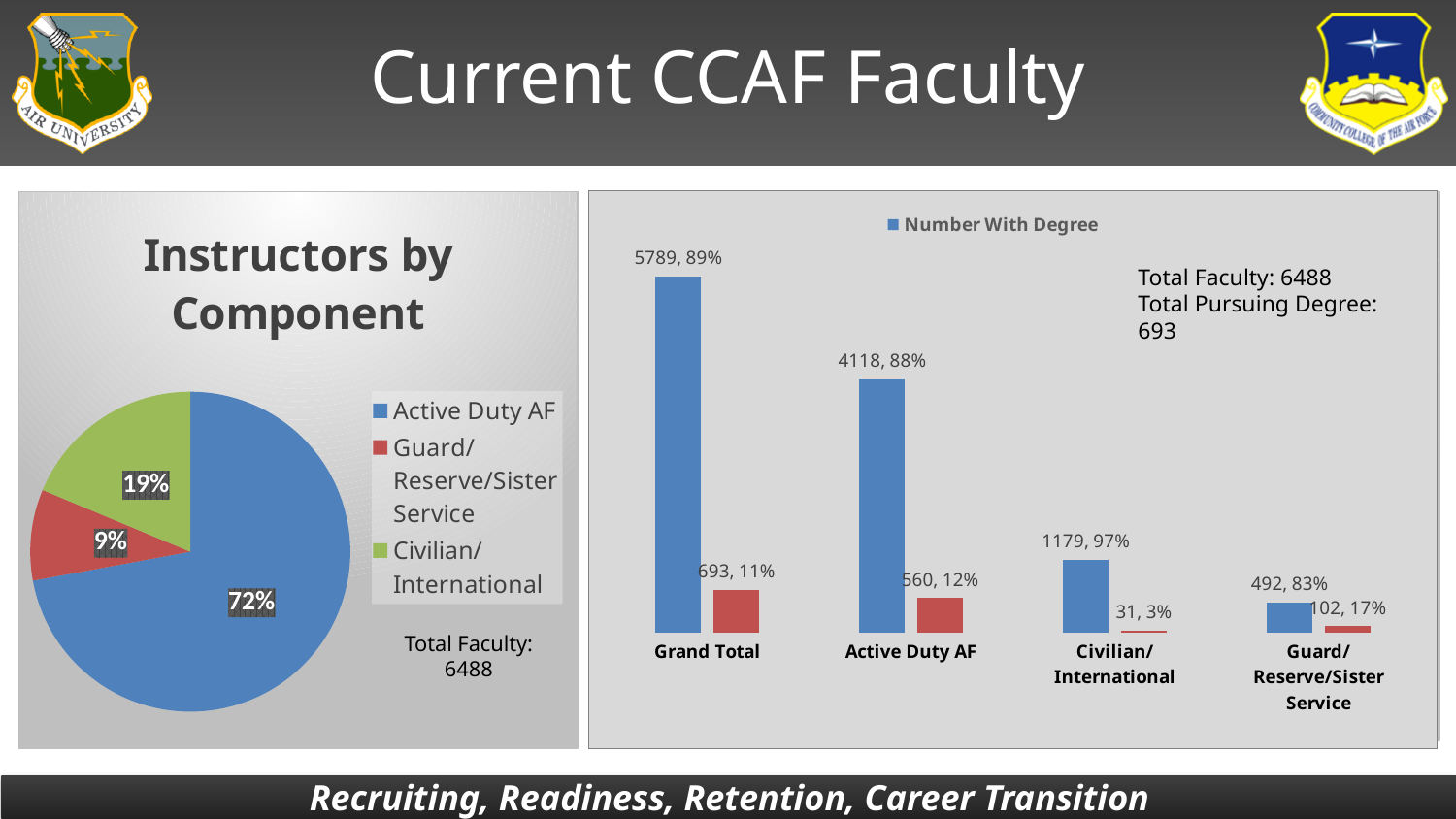
What type of chart is the chart on the right of the slide? Bar chart In the bar chart on the right, what is the Number With Degree value for Civilian/International? 1179, 97% In the bar chart on the right, what is the difference between the Number With Degree for Active Duty AF and for Civilian/International? 2939 In the 'Instructors by Component' pie chart, which component has the smallest slice? Guard/Reserve/Sister Service In the bar chart on the right, what is the Number With Degree value for Guard/Reserve/Sister Service? 492, 83% In the bar chart on the right, what is the Number With Degree value for Grand Total? 5789, 89% In the 'Instructors by Component' pie chart, what share of instructors is Active Duty AF? 72% In the bar chart on the right, how many categories are shown on the x axis? 4 In the 'Instructors by Component' pie chart, what share of instructors is Civilian/International? 19% In the bar chart on the right, which category has the lowest Number With Degree? Guard/Reserve/Sister Service What type of chart is the 'Instructors by Component' chart on the left? Pie chart How many slices does the 'Instructors by Component' pie chart have? 3